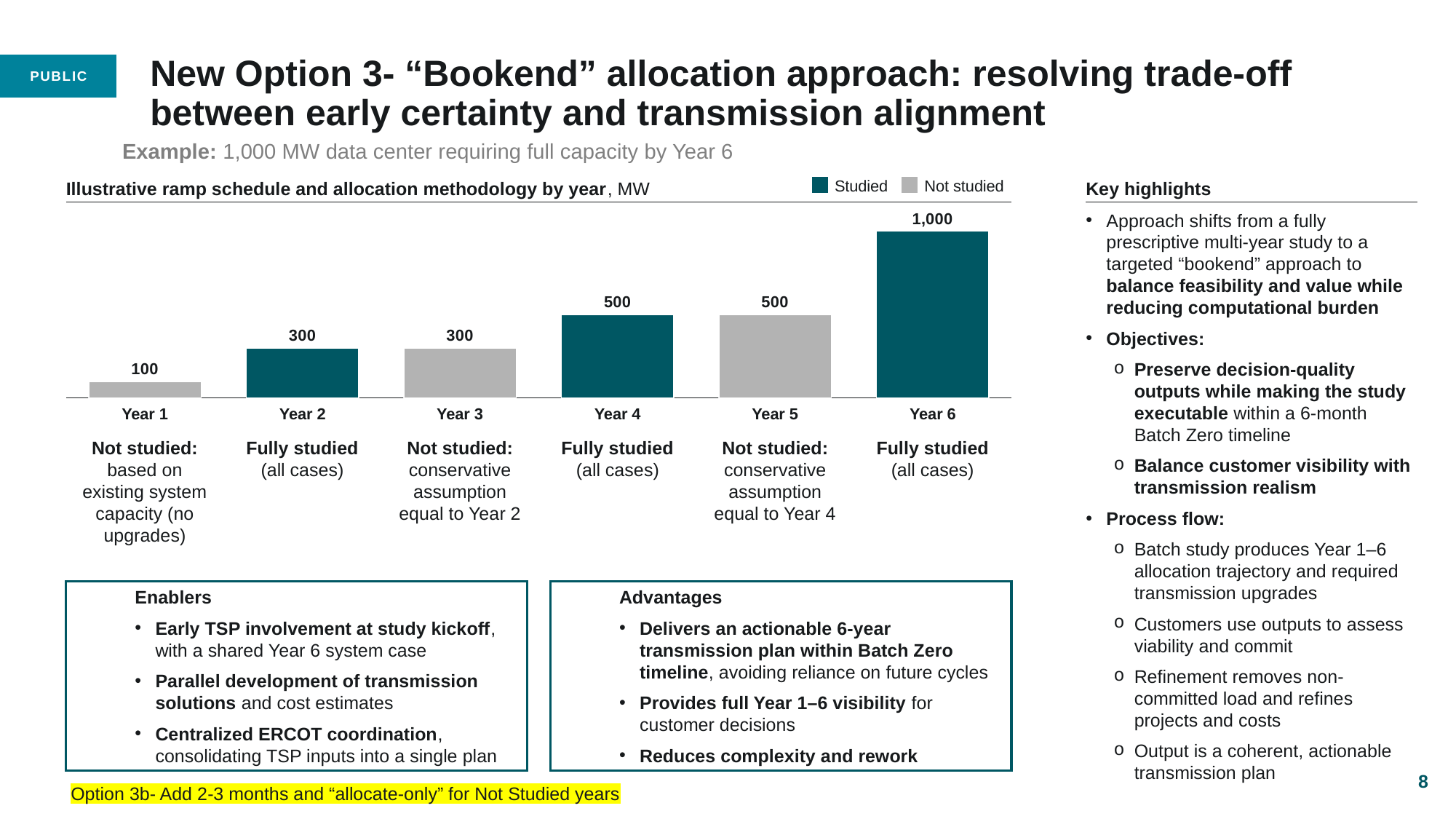
How many years are shown on the x axis? 6 Which is larger, the value for Year 3 or the value for Year 4? Year 4 What is the value for Year 6? 1,000 Which year has the lowest value? Year 1 How many entries does the legend list? 2 What is the value for Year 1? 100 What is the difference between the values for Year 2 and Year 1? 200 Which legend entry is shown in grey? Not studied What kind of chart is shown? Bar chart What is the difference between the values for Year 6 and Year 5? 500 Which year has the highest value? Year 6 What is the value for Year 4? 500